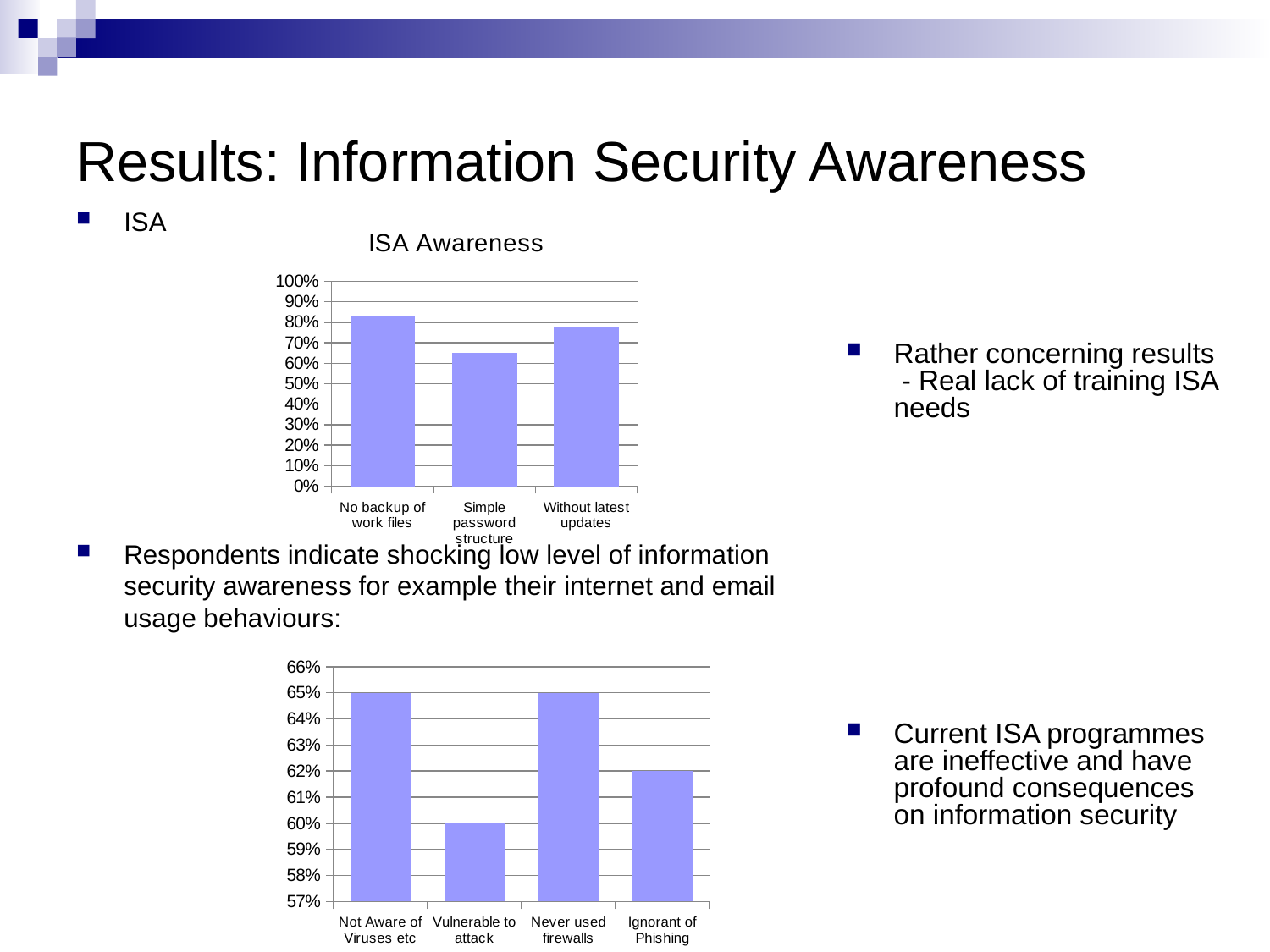
In the bottom chart, what is the difference between Not Aware of Viruses etc and Vulnerable to attack? 5% In the bottom chart, what is the value for Ignorant of Phishing? 62% In the bottom chart, what is the value for Vulnerable to attack? 60% In the bottom chart, what is the value for Never used firewalls? 65% In the bottom chart, how many categories are plotted? 4 What type of chart is the ISA Awareness chart? bar chart In the ISA Awareness chart, is the value for No backup of work files greater or less than 80%? greater In the ISA Awareness chart, is the value for Simple password structure greater or less than 70%? less In the ISA Awareness chart, which category has the lowest bar? Simple password structure In the bottom chart, which category has the lowest value? Vulnerable to attack In the ISA Awareness chart, how many categories are plotted? 3 In the ISA Awareness chart, which category has the highest bar? No backup of work files